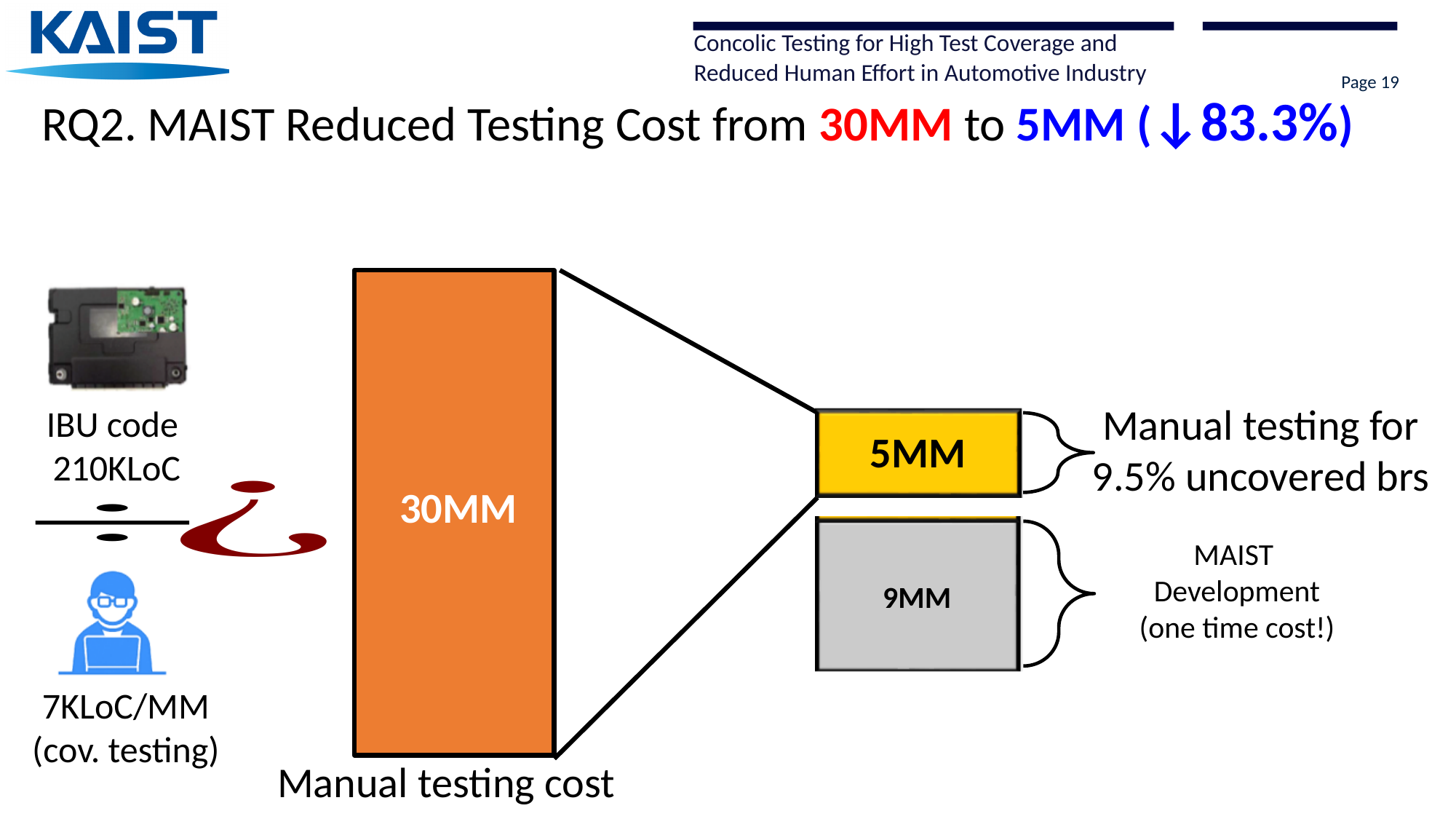
What is the manual testing cost shown on the large orange bar? 30MM What is the cost of manual testing for the 9.5% uncovered branches? 5MM By what percentage did MAIST reduce the testing cost, according to the slide title? 83.3% Which cost is the largest: manual testing cost, manual testing for 9.5% uncovered branches, or MAIST development? Manual testing cost What is the one-time cost of MAIST development? 9MM By how much is the manual testing cost (30MM) larger than the manual testing cost for 9.5% uncovered branches (5MM)? 25MM How many cost values are shown as bars on the slide? 3 Which is larger: the MAIST development cost or the manual testing cost for 9.5% uncovered branches? MAIST development cost What is the difference between the MAIST development cost and the manual testing cost for 9.5% uncovered branches? 4MM What colour is the bar representing the 5MM manual testing cost? Yellow What is the combined cost of the 5MM manual testing and the 9MM MAIST development? 14MM Which cost is the smallest: manual testing cost, manual testing for 9.5% uncovered branches, or MAIST development? Manual testing for 9.5% uncovered brs